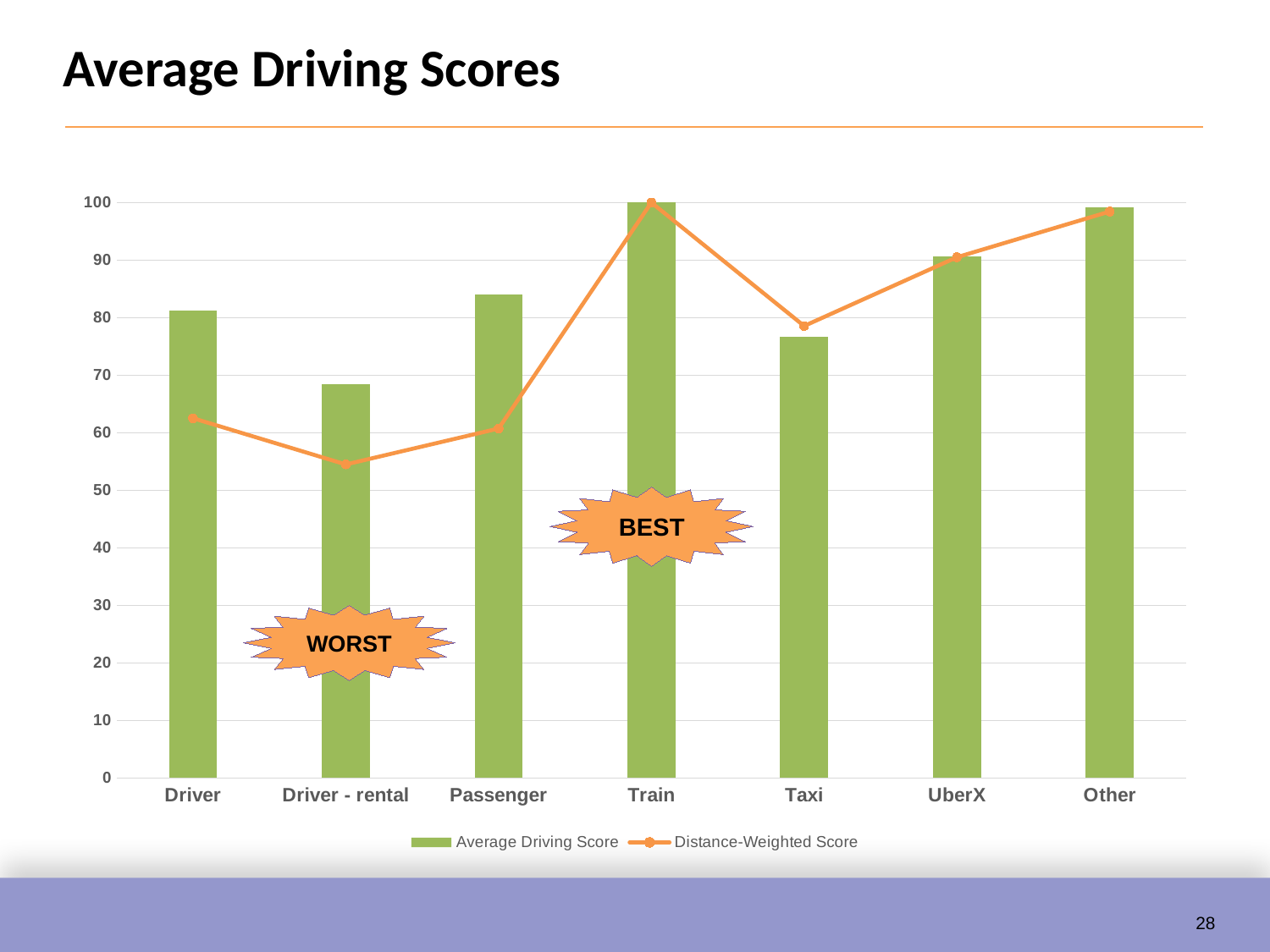
Which category has the lowest Distance-Weighted Score? Driver - rental Which category has the highest Distance-Weighted Score? Train What kind of chart is shown on the slide? A combined bar and line chart Is the Distance-Weighted Score for Taxi greater or less than 70? greater How many series does the legend list? 2 Which category has the lowest Average Driving Score? Driver - rental How many categories are shown on the x axis? 7 Which has a higher Average Driving Score, Passenger or Taxi? Passenger What is the title of the slide containing the chart? Average Driving Scores Which category has the highest Average Driving Score? Train Which has a higher Distance-Weighted Score, Driver or UberX? UberX Is the Average Driving Score for Driver - rental greater or less than 70? less